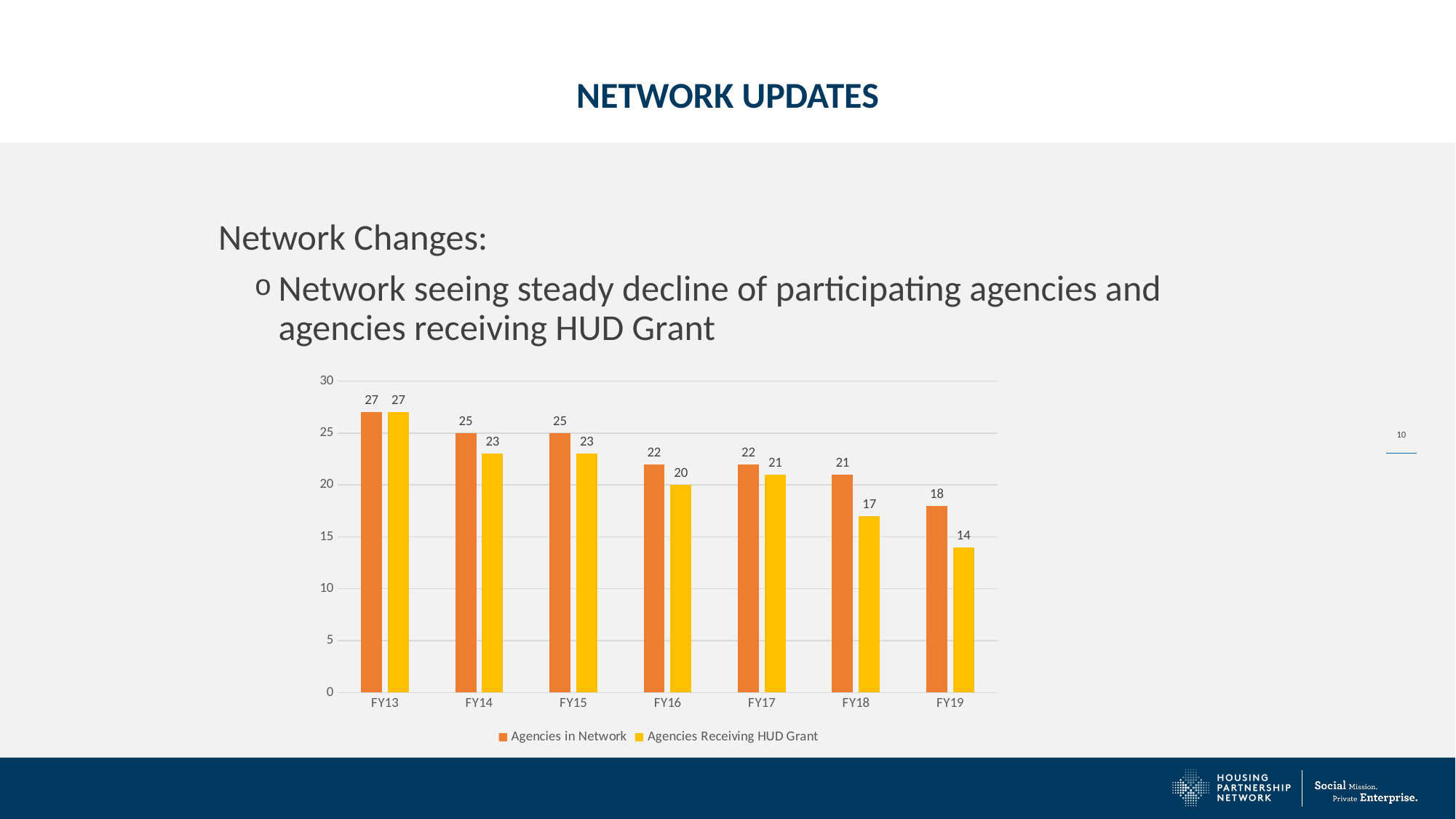
Which is larger in FY17: Agencies in Network or Agencies Receiving HUD Grant? Agencies in Network What kind of chart is shown on the slide? Bar chart What is the difference between Agencies in Network in FY13 and in FY19? 9 What is the difference between Agencies in Network and Agencies Receiving HUD Grant in FY18? 4 How many fiscal years are shown on the x axis? 7 Do the values for Agencies Receiving HUD Grant rise or fall from FY13 to FY19? Fall What is the value for Agencies Receiving HUD Grant in FY19? 14 What is the value for Agencies in Network in FY16? 22 Which fiscal year has the lowest value for Agencies Receiving HUD Grant? FY19 What is the value for Agencies Receiving HUD Grant in FY14? 23 Which fiscal year has the highest value for Agencies in Network? FY13 How many series does the legend list? 2